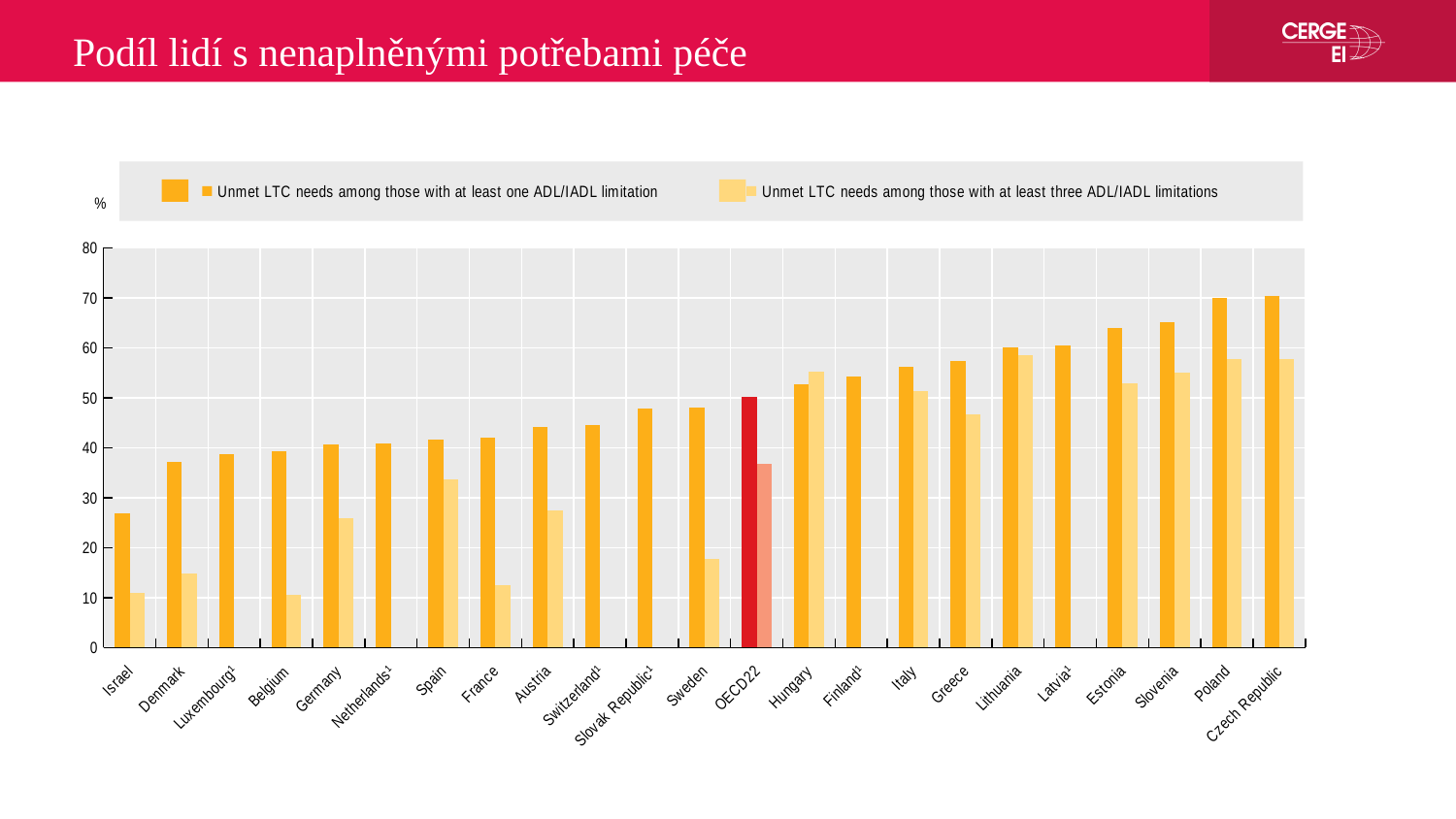
What kind of chart is shown on the slide? bar chart Is the value for Sweden for unmet LTC needs among those with at least three ADL/IADL limitations greater or less than 20? less How many series does the legend list? 2 How many countries/categories are shown on the x axis? 23 Which category is highlighted in red on the chart? OECD22 Is the value for Israel for unmet LTC needs among those with at least one ADL/IADL limitation greater or less than 30? less Is the value for OECD22 for unmet LTC needs among those with at least three ADL/IADL limitations greater or less than 40? less Do the values for unmet LTC needs among those with at least one ADL/IADL limitation rise or fall from left to right along the x axis? rise Which is larger for unmet LTC needs among those with at least one ADL/IADL limitation: Israel or Denmark? Denmark Which is larger for unmet LTC needs among those with at least three ADL/IADL limitations: Germany or Spain? Spain Which category has the lowest value for unmet LTC needs among those with at least one ADL/IADL limitation? Israel